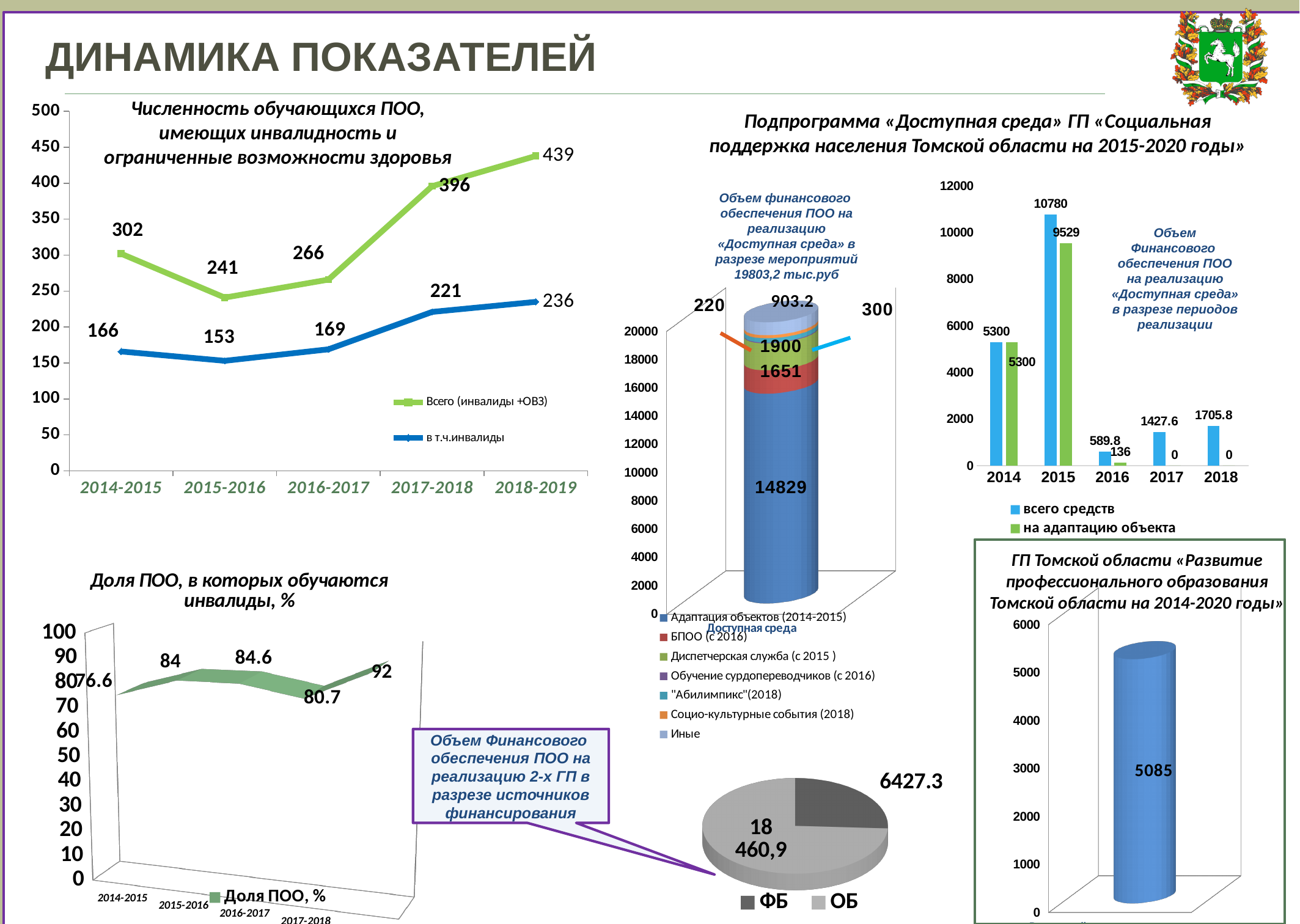
In the chart 'ГП Томской области «Развитие профессионального образования Томской области на 2014-2020 годы»', what value is shown on the bar? 5085 In the chart 'Численность обучающихся ПОО, имеющих инвалидность и ограниченные возможности здоровья', what is the value of 'в т.ч.инвалиды' for 2015-2016? 153 In the chart 'Доля ПОО, в которых обучаются инвалиды, %', what is the value for 2017-2018? 80.7 In the bar chart 'Объем Финансового обеспечения ПОО на реализацию «Доступная среда» в разрезе периодов реализации', what is the difference between 'всего средств' and 'на адаптацию объекта' in 2015? 1251 In the stacked chart 'Объем финансового обеспечения ПОО на реализацию «Доступная среда» в разрезе мероприятий', what is the value of the largest segment, 'Адаптация объектов (2014-2015)'? 14829 In the chart 'Численность обучающихся ПОО, имеющих инвалидность и ограниченные возможности здоровья', how many series does the legend list? 2 In the chart 'Численность обучающихся ПОО, имеющих инвалидность и ограниченные возможности здоровья', what is the value of 'Всего (инвалиды +ОВЗ)' for 2018-2019? 439 In the bar chart 'Объем Финансового обеспечения ПОО на реализацию «Доступная среда» в разрезе периодов реализации', what is the value of 'всего средств' for 2015? 10780 In the pie chart showing funding by source (ФБ and ОБ), what is the value for ФБ? 6427.3 In the chart 'Численность обучающихся ПОО, имеющих инвалидность и ограниченные возможности здоровья', what is the difference between 'Всего (инвалиды +ОВЗ)' and 'в т.ч.инвалиды' in 2017-2018? 175 In the bar chart 'Объем Финансового обеспечения ПОО на реализацию «Доступная среда» в разрезе периодов реализации', which year has the lowest value of 'всего средств'? 2016